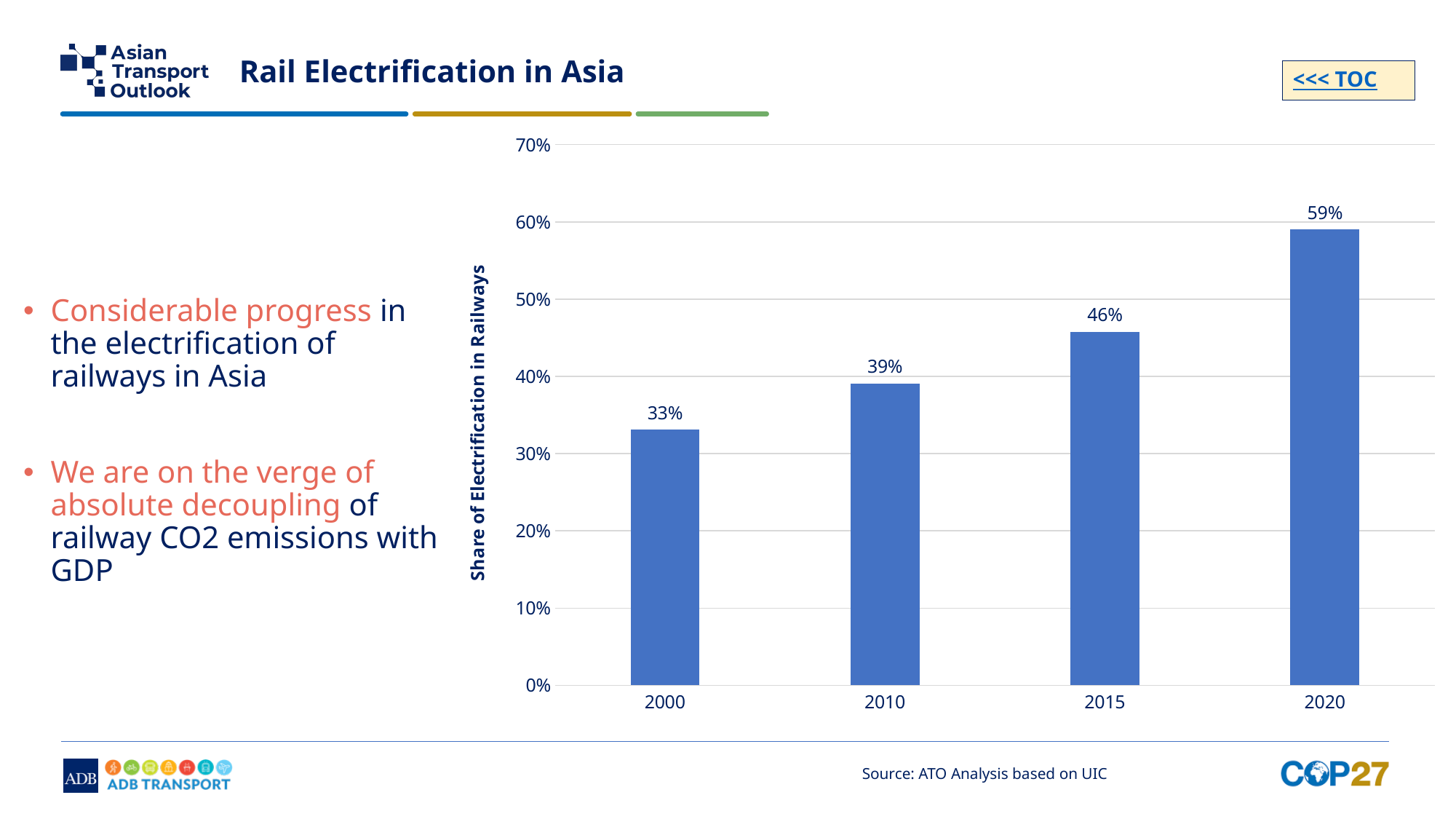
What is the share of electrification in railways in 2000? 33% Does the share of electrification in railways rise or fall from 2000 to 2020? Rise What is the difference in the share of electrification between 2015 and 2010? 7% What type of chart is shown on the slide? Bar chart How many years are shown on the x axis of the chart? 4 Which year has the highest share of electrification in railways? 2020 What is the share of electrification in railways in 2010? 39% What is the share of electrification in railways in 2015? 46% Which year has the lowest share of electrification in railways? 2000 What is the share of electrification in railways in 2020? 59% Which year has a larger share of electrification, 2010 or 2015? 2015 What is the difference in the share of electrification between 2020 and 2000? 26%